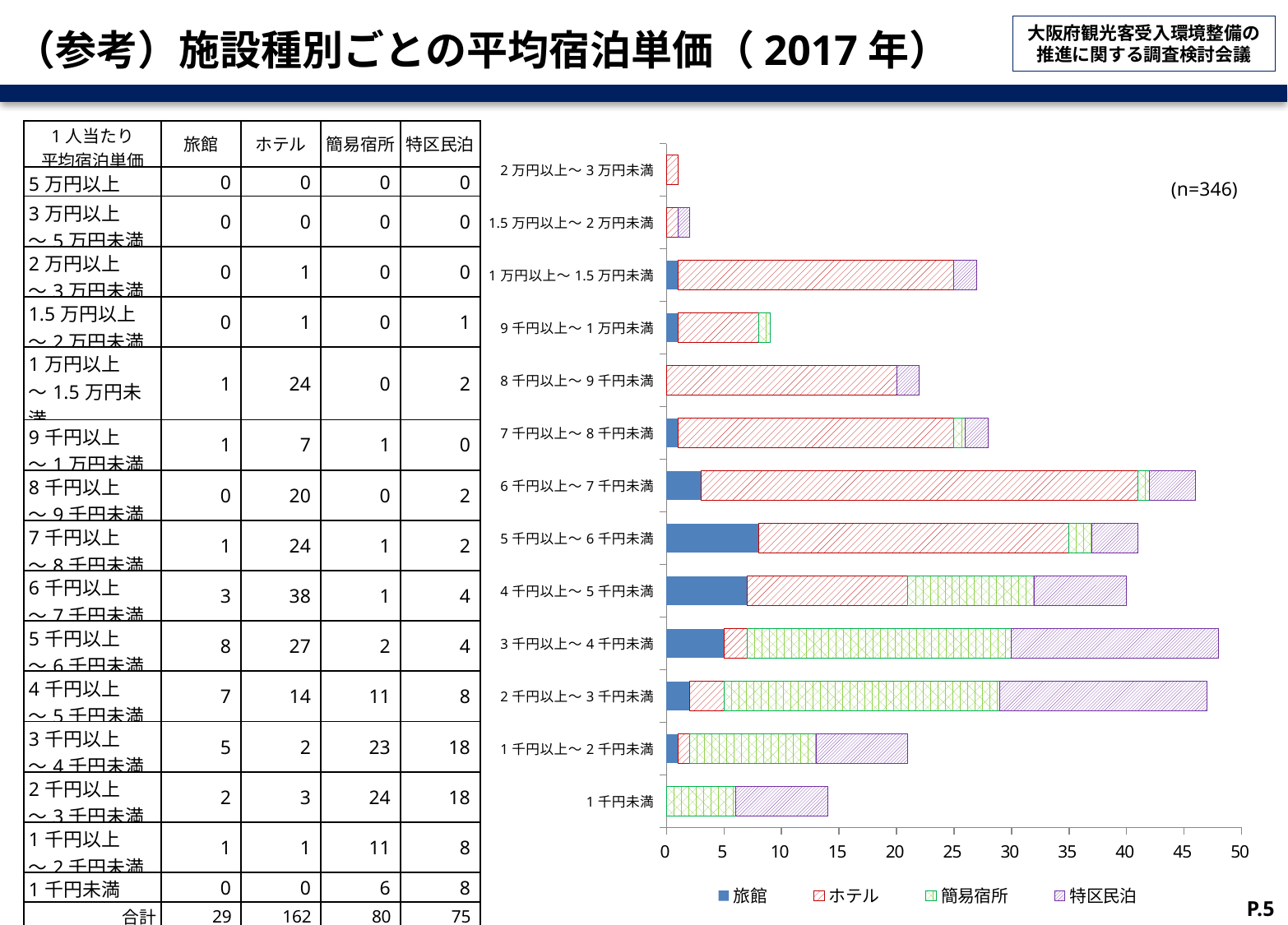
Which price-range category has the shortest total bar in the chart? 2万円以上～3万円未満 What kind of chart is shown on the slide? stacked bar chart What is the value for 簡易宿所 in the 2千円以上～3千円未満 category? 24 What is the total of the stacked bar for 4千円以上～5千円未満? 40 What is the difference between the 特区民泊 value and the 旅館 value in the 3千円以上～4千円未満 category? 13 How many series does the chart legend list? 4 What sample size (n) is shown next to the chart? n=346 Which is larger in the 5千円以上～6千円未満 category, the 旅館 value or the ホテル value? ホテル What is the value for ホテル in the 6千円以上～7千円未満 category? 38 Is the total bar for 8千円以上～9千円未満 greater or less than 25? less Which price-range category has the longest total bar in the chart? 3千円以上～4千円未満 How many price-range categories are plotted in the bar chart? 13